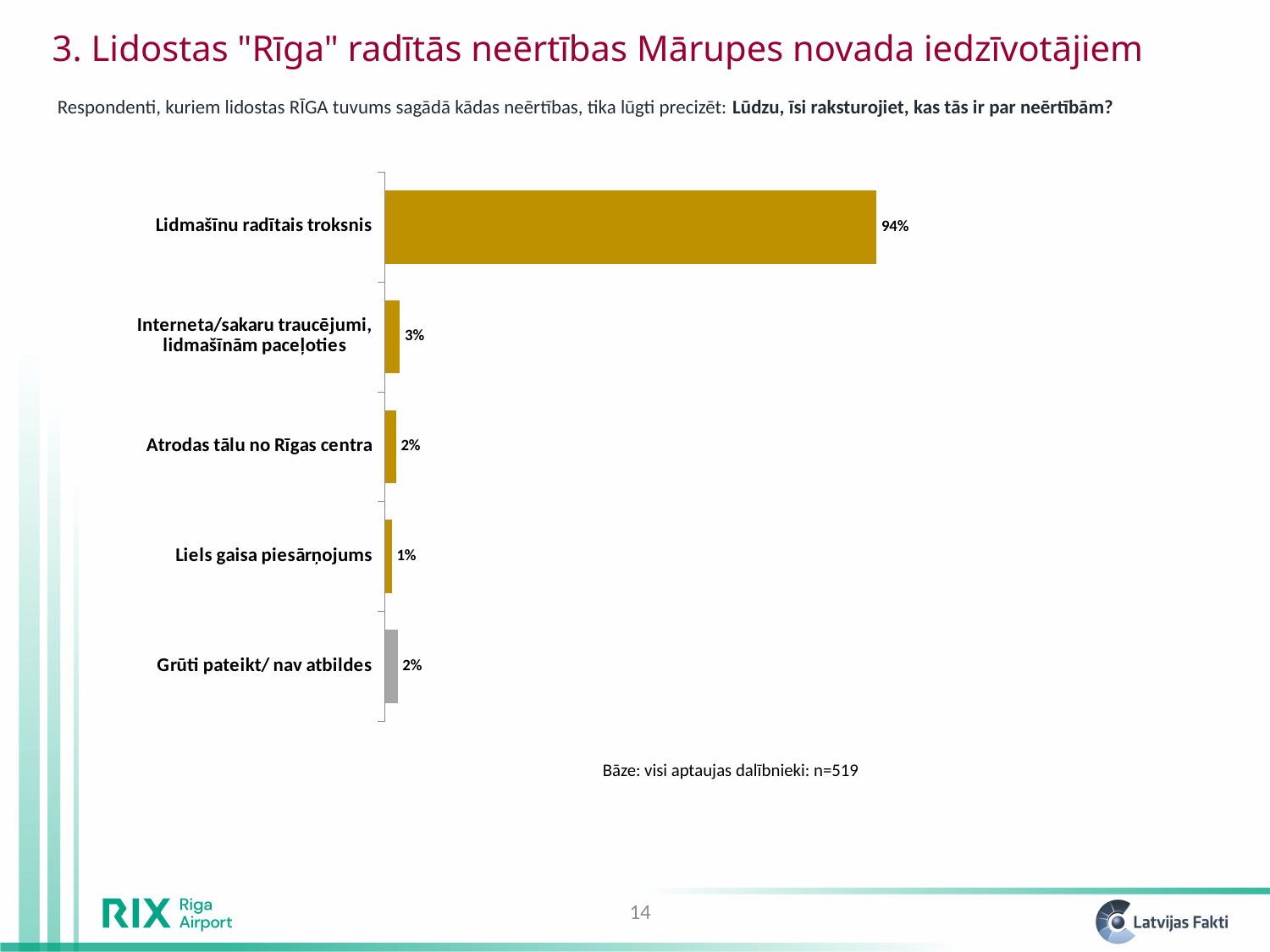
What kind of chart is shown on the slide? Bar chart What is the difference between the values for "Lidmašīnu radītais troksnis" and "Interneta/sakaru traucējumi, lidmašīnām paceļoties"? 91% What is the value for "Atrodas tālu no Rīgas centra"? 2% How many categories are shown in the chart? 5 Which category has the lowest value? Liels gaisa piesārņojums What is the value for "Grūti pateikt/ nav atbildes"? 2% What is the value for "Interneta/sakaru traucējumi, lidmašīnām paceļoties"? 3% What is the base (n) stated below the chart? n=519 Which is larger: the value for "Interneta/sakaru traucējumi, lidmašīnām paceļoties" or the value for "Liels gaisa piesārņojums"? Interneta/sakaru traucējumi, lidmašīnām paceļoties What is the value for "Liels gaisa piesārņojums"? 1% Which category has the highest value? Lidmašīnu radītais troksnis What is the value for "Lidmašīnu radītais troksnis"? 94%